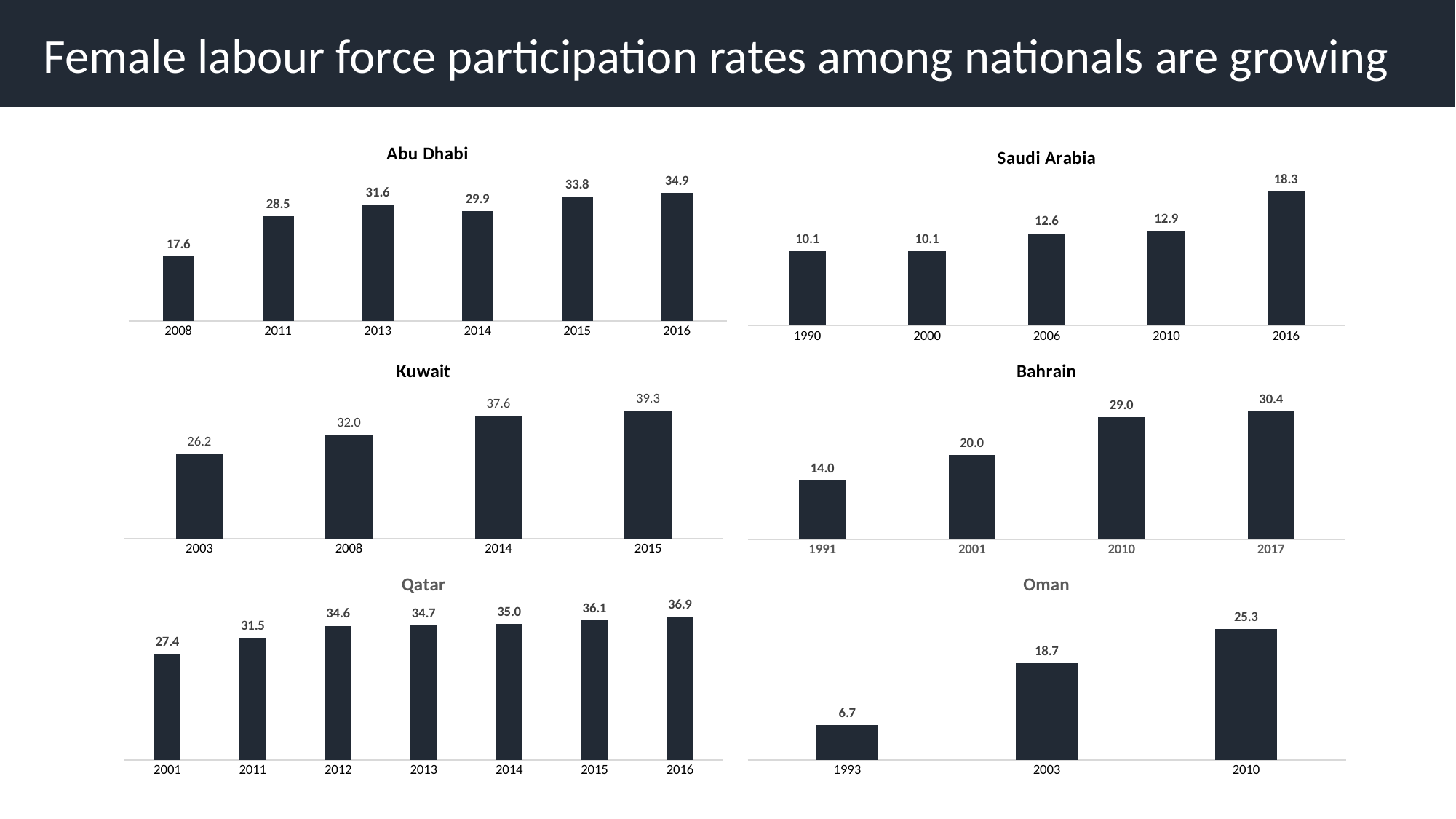
What kind of chart is the Kuwait chart? bar chart How many charts are shown on the slide? 6 In the Saudi Arabia chart, what is the value for 2016? 18.3 In the Bahrain chart, which year has the lowest value? 1991 How many bars are in the Oman chart? 3 In the Abu Dhabi chart, what is the value for 2008? 17.6 In the Kuwait chart, which year has the highest value? 2015 In the Oman chart, what is the value for 2003? 18.7 In the Bahrain chart, do the values rise or fall from 1991 to 2017? rise How many bars are in the Qatar chart? 7 In the Abu Dhabi chart, which is larger, the value for 2013 or the value for 2014? 2013 In the Qatar chart, what is the difference between the values for 2016 and 2001? 9.5